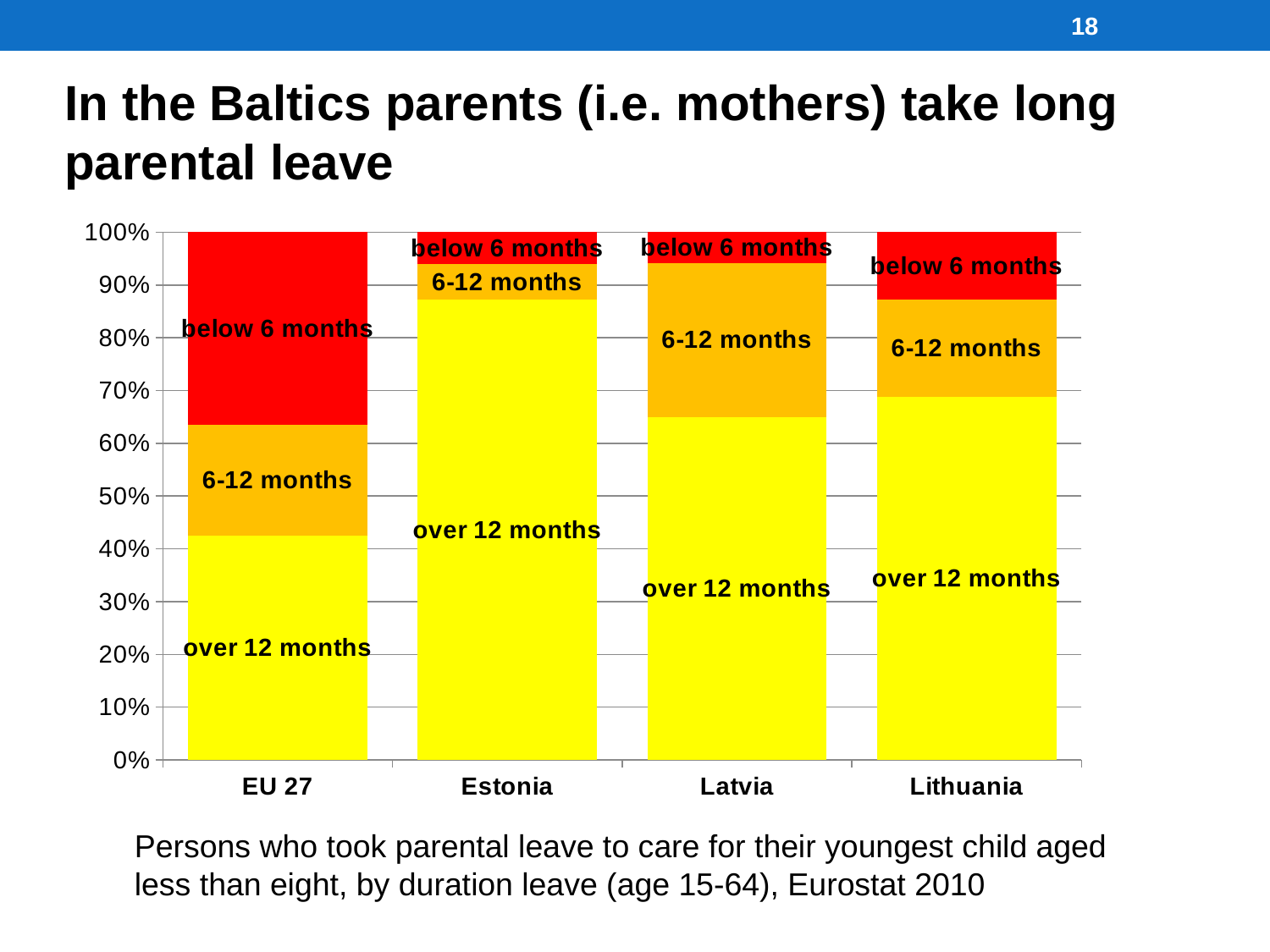
What kind of chart is shown on the slide? Stacked bar chart Is the 'below 6 months' share for Lithuania greater or less than 20%? less How many duration-of-leave segments make up each bar in the chart? 3 Which category has the smallest 'over 12 months' segment? EU 27 How many categories are shown on the x axis of the chart? 4 Which category has the largest '6-12 months' segment? Latvia Is the 'over 12 months' share for Estonia greater or less than 80%? greater Which has a larger '6-12 months' segment, Latvia or Lithuania? Latvia Is the 'over 12 months' share for EU 27 greater or less than 50%? less What is the total of the stacked bar for Latvia? 100% Which category has the largest 'over 12 months' segment? Estonia Which category has the largest 'below 6 months' segment? EU 27